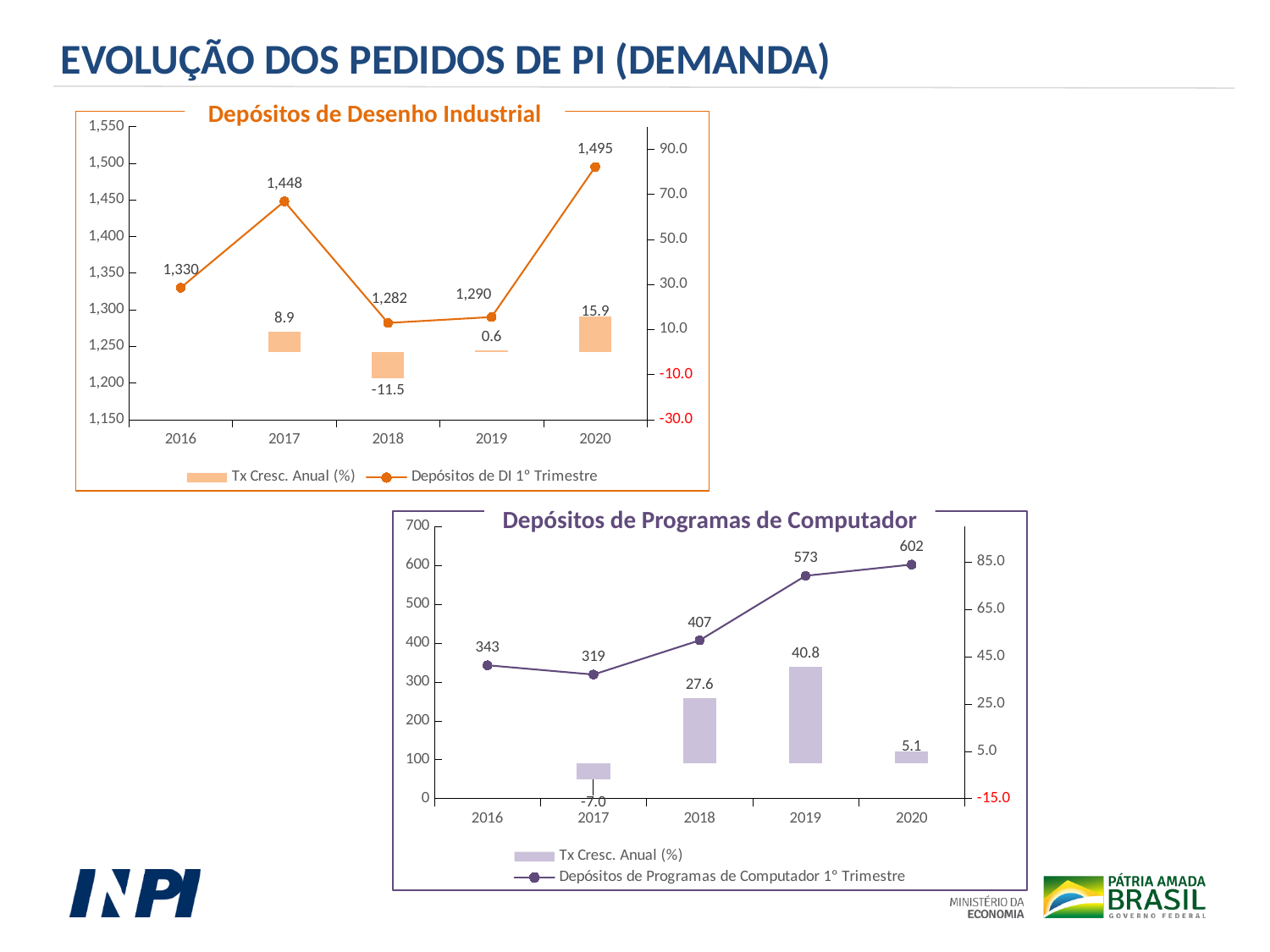
In the 'Depósitos de Programas de Computador' chart, which year has the highest Tx Cresc. Anual (%)? 2019 In the 'Depósitos de Programas de Computador' chart, how many years are shown on the x axis? 5 In the 'Depósitos de Desenho Industrial' chart, what is the Tx Cresc. Anual (%) for 2018? -11.5 In the 'Depósitos de Desenho Industrial' chart, what is the value of Depósitos de DI 1° Trimestre for 2020? 1,495 In the 'Depósitos de Desenho Industrial' chart, what is the difference between the Depósitos de DI 1° Trimestre values for 2017 and 2016? 118 In the 'Depósitos de Desenho Industrial' chart, which year has the lowest value of Depósitos de DI 1° Trimestre? 2018 In the 'Depósitos de Desenho Industrial' chart, how many series does the legend list? 2 In the 'Depósitos de Programas de Computador' chart, what is the value of Depósitos de Programas de Computador 1° Trimestre for 2019? 573 In the 'Depósitos de Programas de Computador' chart, which is larger: the Depósitos de Programas de Computador 1° Trimestre value for 2016 or for 2017? 2016 In the 'Depósitos de Programas de Computador' chart, what is the difference between the Depósitos de Programas de Computador 1° Trimestre values for 2020 and 2019? 29 In the 'Depósitos de Programas de Computador' chart, what is the Tx Cresc. Anual (%) for 2017? -7.0 In the 'Depósitos de Programas de Computador' chart, do the Depósitos de Programas de Computador 1° Trimestre values rise or fall from 2017 to 2020? rise